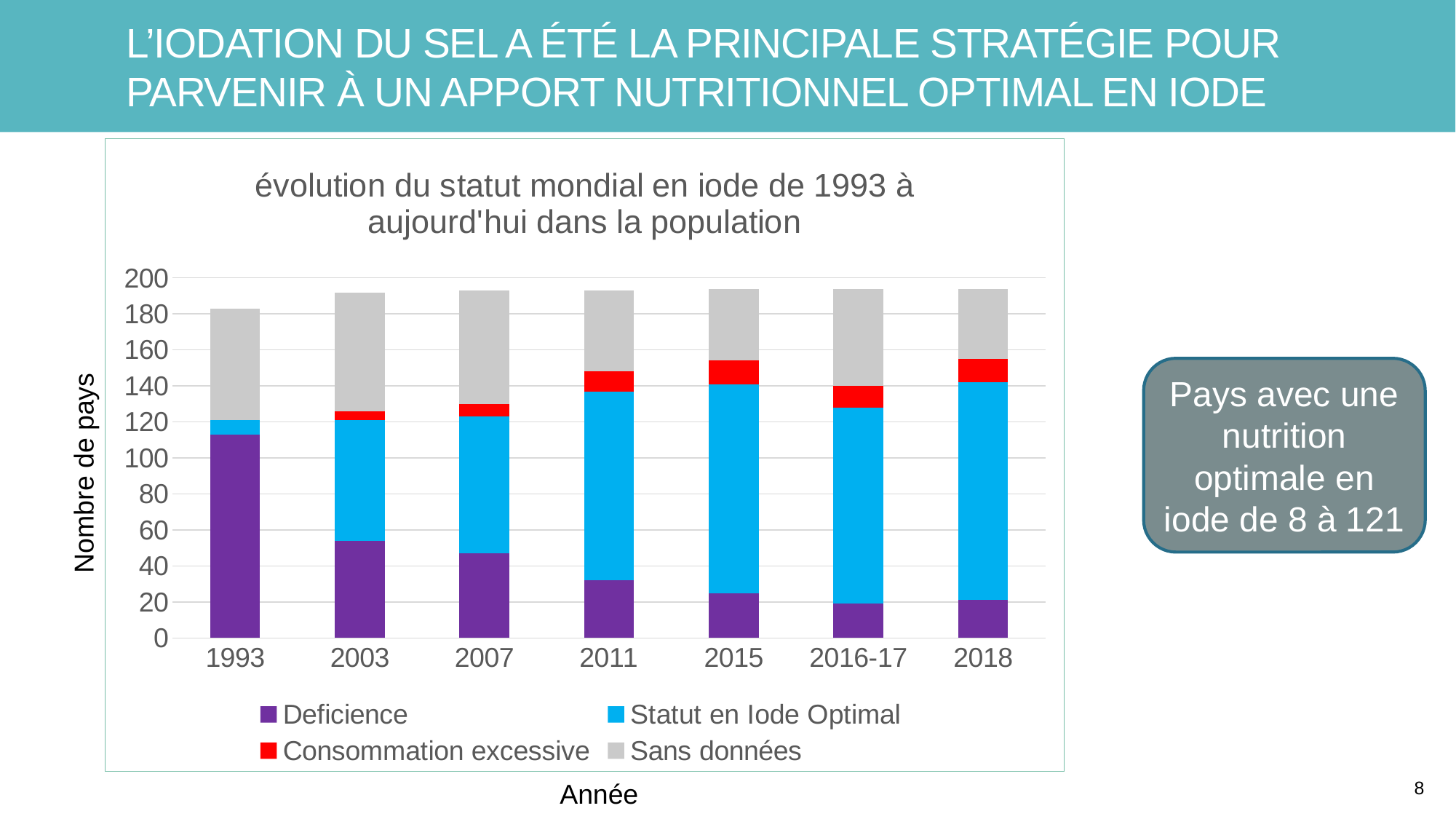
How many years (categories) are shown on the x axis of the chart? 7 Is the total height of the 1993 bar greater or less than 190? less Is the Deficience value for 2011 greater or less than 40? less Which year has the highest Deficience value? 1993 Is the Deficience value for 1993 greater or less than 100? greater What is the label of the y axis of the chart? Nombre de pays What kind of chart is shown on the slide? Stacked bar chart Does the Deficience segment rise or fall overall from 1993 to 2018? Falls Which series is shown in red in the chart legend? Consommation excessive Which year has the larger Deficience value, 2003 or 2007? 2003 How many series does the chart legend list? 4